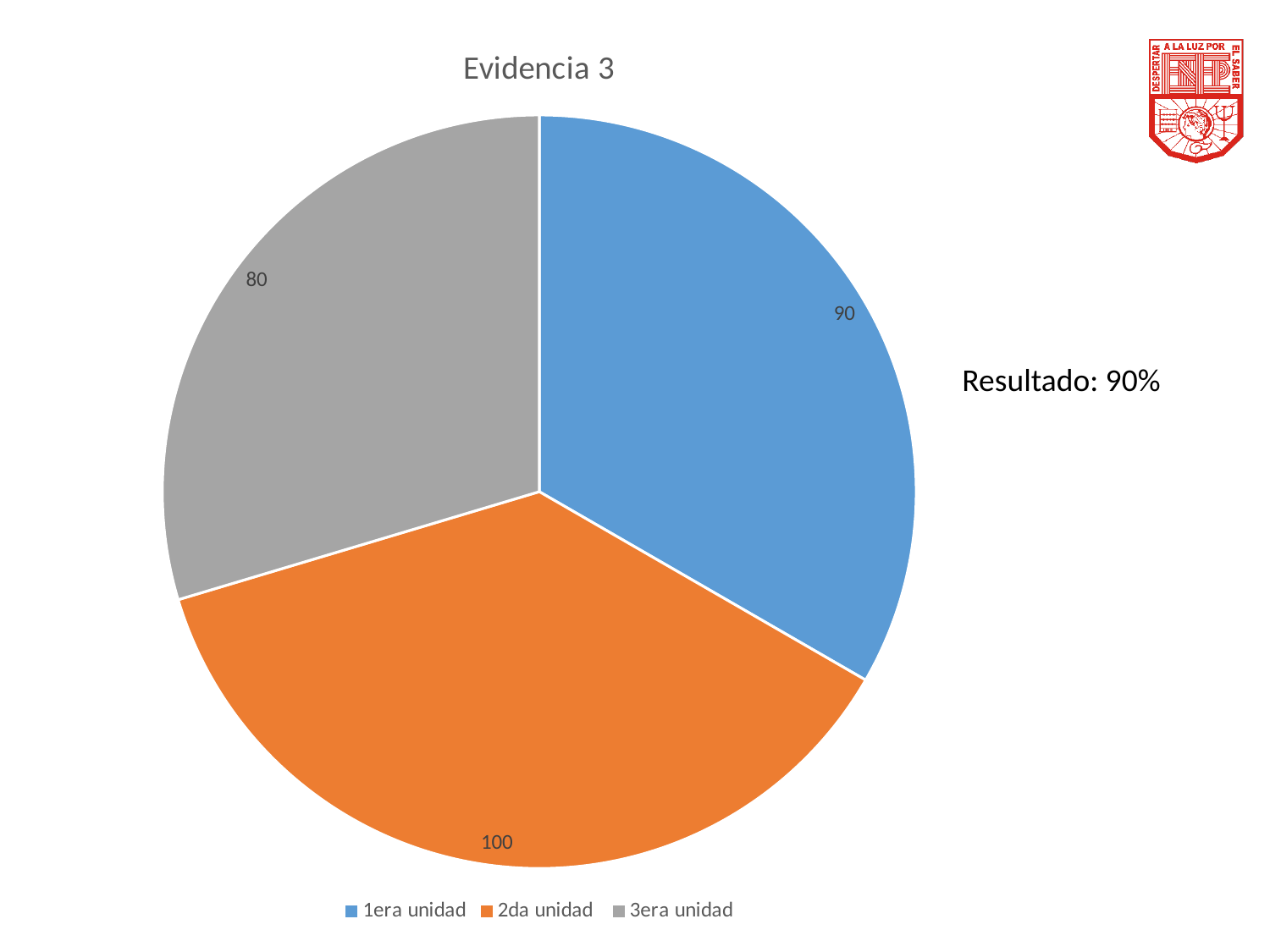
What is the value for 1era unidad? 90 Which category has the highest value? 2da unidad What is the value for 2da unidad? 100 Which is larger, the value for 1era unidad or the value for 3era unidad? 1era unidad What is the total of all slices in the pie chart? 270 Which category has the lowest value? 3era unidad What is the value for 3era unidad? 80 What kind of chart is shown on the slide? pie chart What is the difference between the values for 2da unidad and 3era unidad? 20 How many slices does the pie chart have? 3 Which colour represents 2da unidad in the legend? orange What is the title of the chart? Evidencia 3